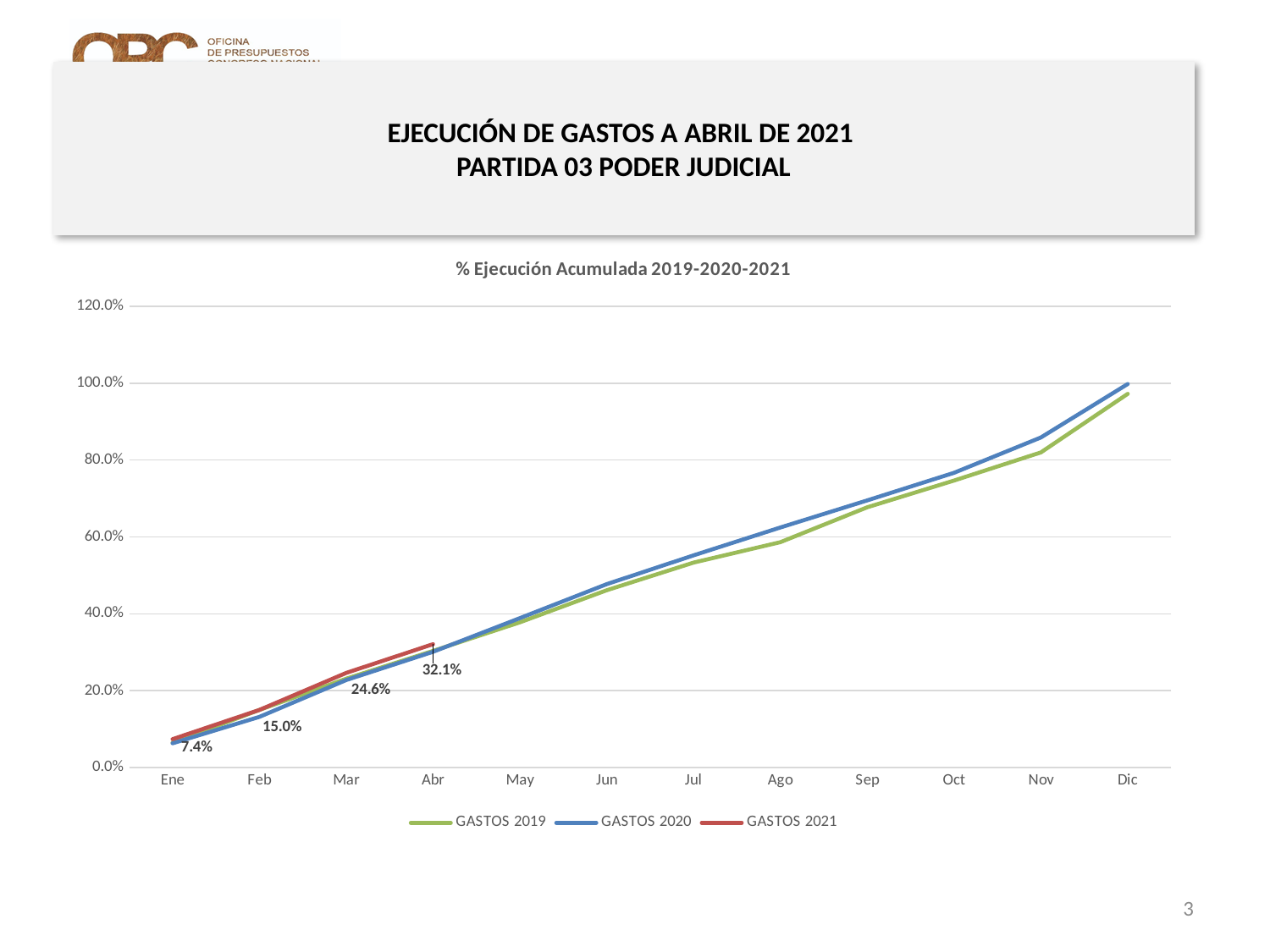
Which series is higher in Nov, GASTOS 2019 or GASTOS 2020? GASTOS 2020 What is the value for GASTOS 2021 in Feb? 15.0% How many series does the legend list? 3 How many months are shown on the x axis? 12 What is the difference between the GASTOS 2021 values for Abr and Mar? 7.5% Do the GASTOS 2021 values rise or fall from Ene to Abr? rise What kind of chart is shown on the slide? line chart What is the value for GASTOS 2021 in Mar? 24.6% What is the value for GASTOS 2021 in Ene? 7.4% What is the title of the chart? % Ejecución Acumulada 2019-2020-2021 Is the value for GASTOS 2019 in Nov greater or less than 100.0%? less What is the value for GASTOS 2021 in Abr? 32.1%